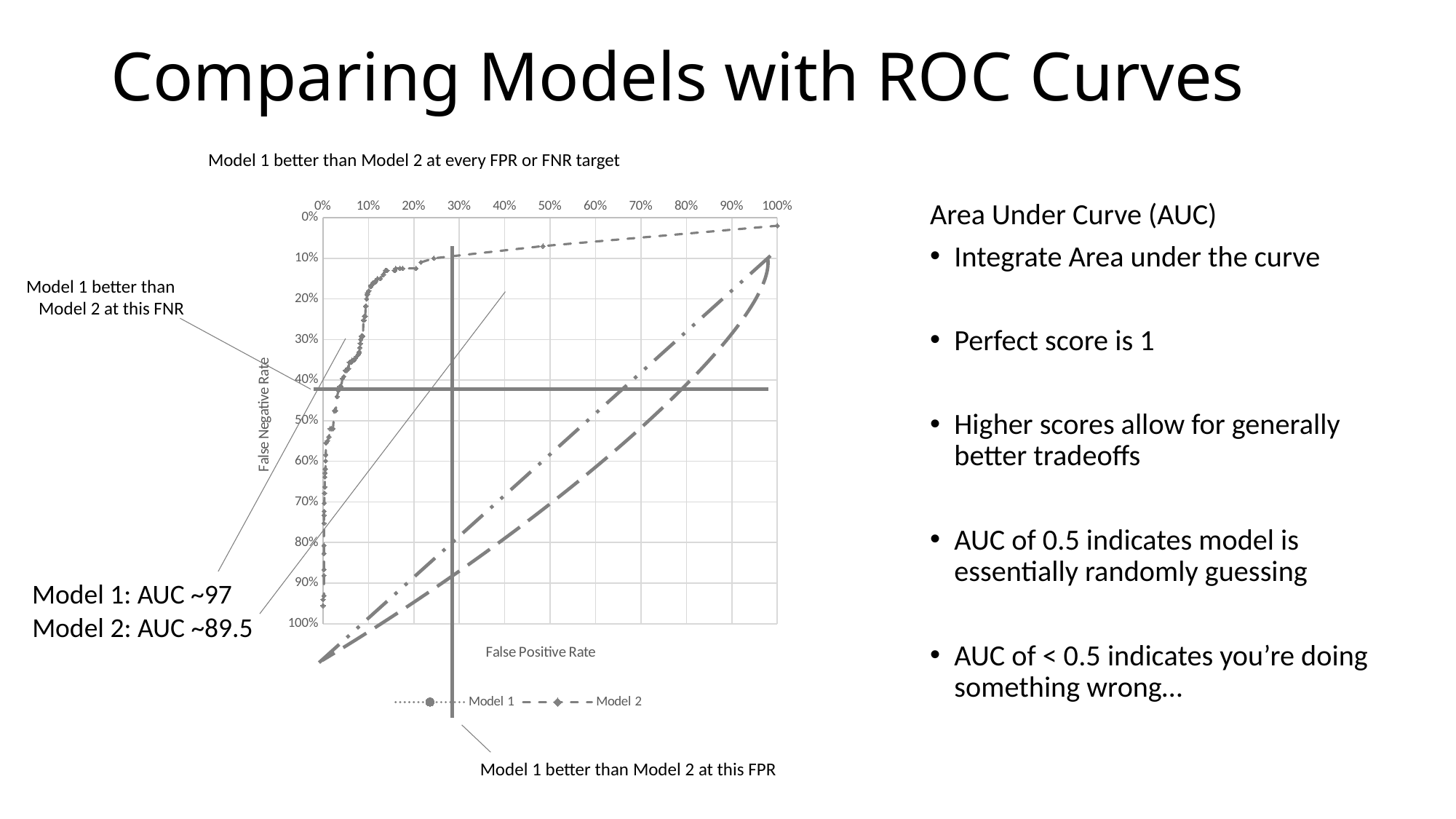
How many series does the chart legend list? 2 What are the names of the two series in the chart legend? Model 1 and Model 2 What is the title of the chart's horizontal axis? False Positive Rate Is the False Negative Rate for Model 2 at a False Positive Rate of 50% greater or less than 30%? less Does the False Negative Rate for Model 1 rise or fall as the False Positive Rate increases? fall What is the highest value shown on the horizontal axis of the chart? 100% What kind of chart is shown on the slide? line chart Is the False Negative Rate for Model 1 at a False Positive Rate of 50% greater or less than 20%? less Is the False Negative Rate for Model 1 at a False Positive Rate of 0% greater or less than 80%? greater At a False Positive Rate of 30%, which model has the lower False Negative Rate? Model 1 At a False Positive Rate of 80%, which model has the higher False Negative Rate? Model 2